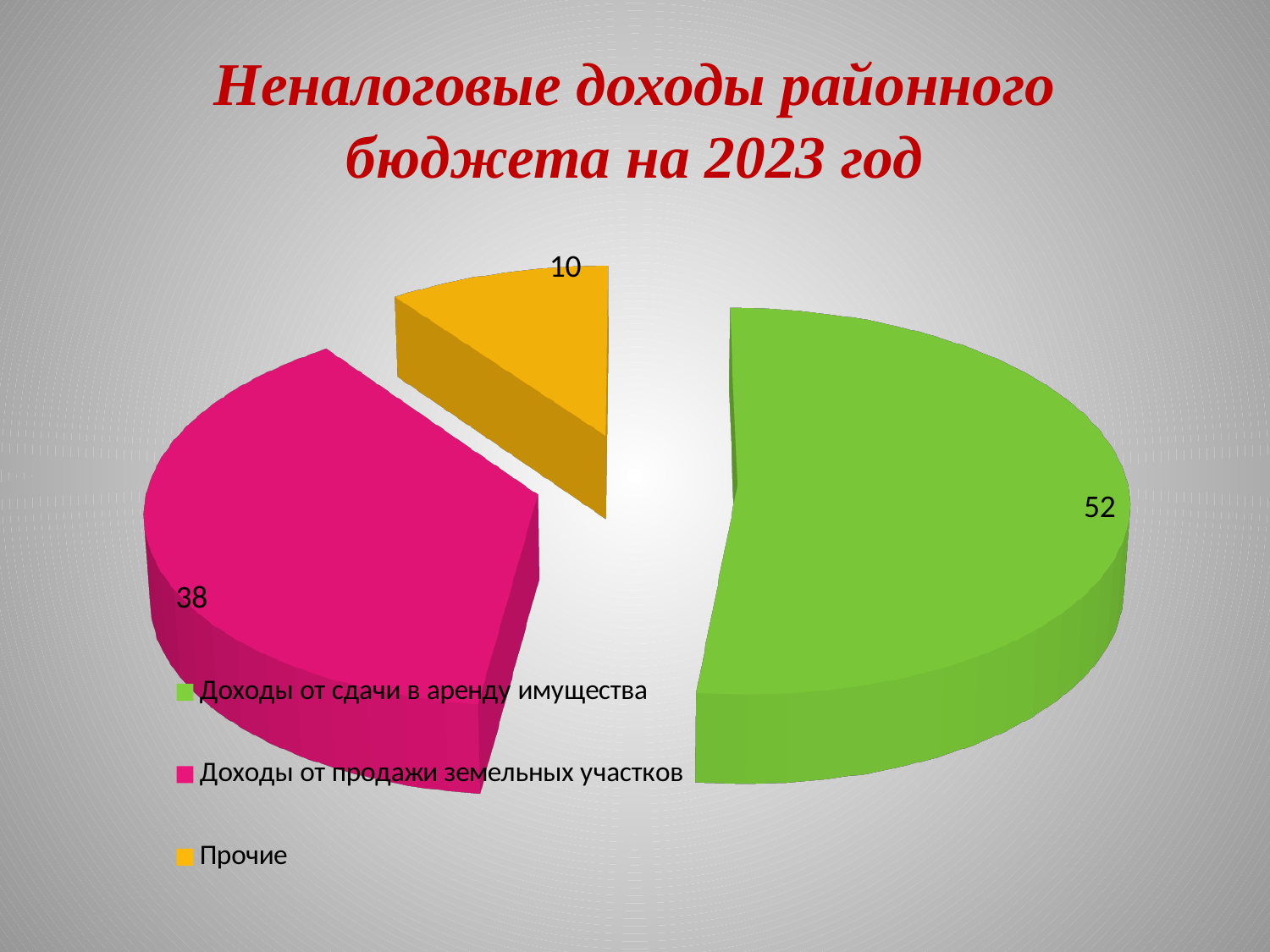
What share of the pie does Прочие represent? 10% What is the difference between the values for Доходы от сдачи в аренду имущества and Доходы от продажи земельных участков? 14 What is the value for Прочие? 10 Which category has the smallest slice of the pie? Прочие What is the difference between the values for Доходы от продажи земельных участков and Прочие? 28 What is the value for Доходы от сдачи в аренду имущества? 52 Which category has the largest slice of the pie? Доходы от сдачи в аренду имущества What type of chart is shown on the slide? pie chart How many slices does the pie chart have? 3 What is the value for Доходы от продажи земельных участков? 38 Which is larger: Доходы от продажи земельных участков or Прочие? Доходы от продажи земельных участков What is the title of the chart on the slide? Неналоговые доходы районного бюджета на 2023 год